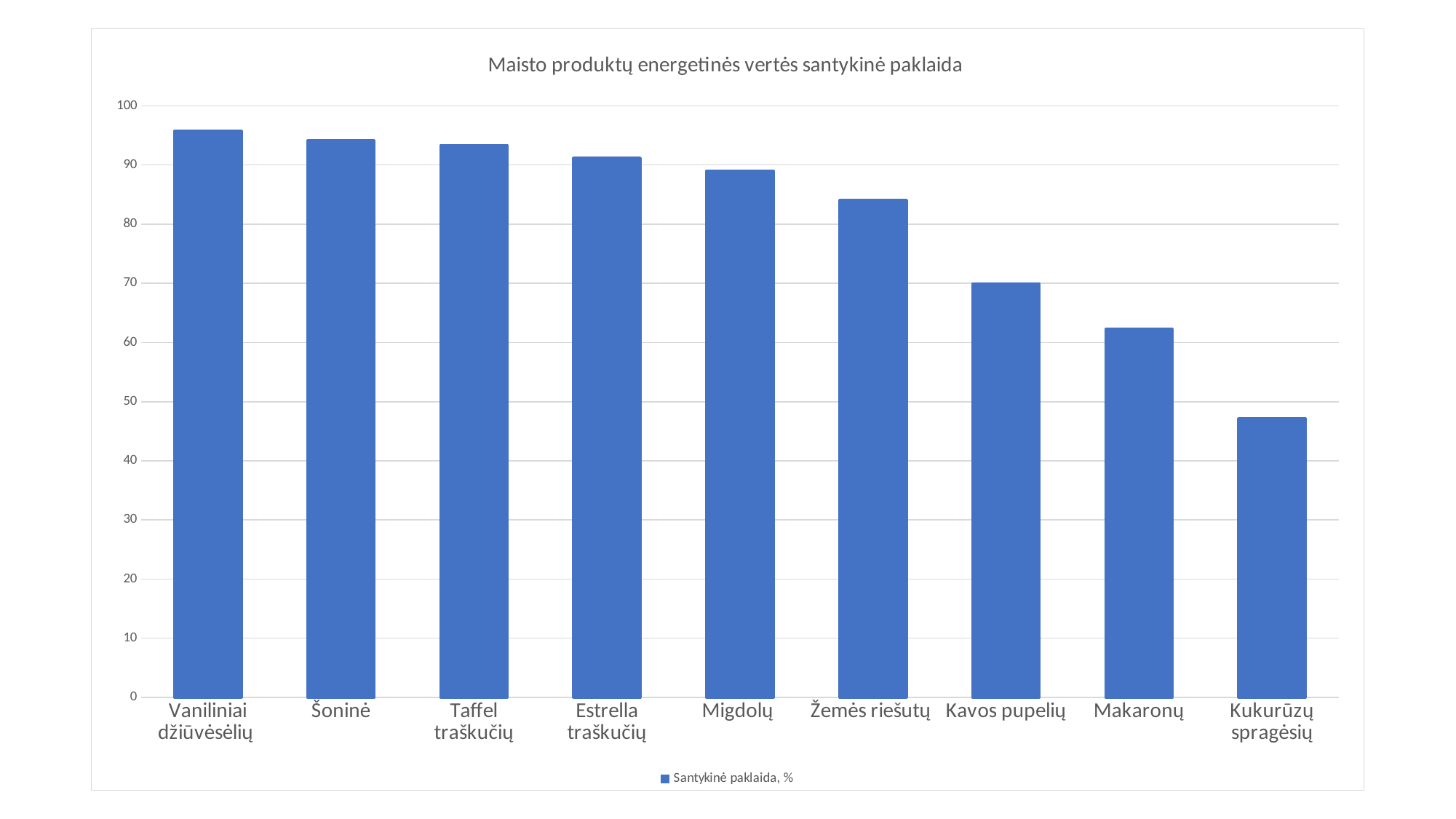
Which category has the highest value? Vaniliniai džiūvėsėlių How many food product categories are shown on the x axis? 9 What is the legend entry for the series? Santykinė paklaida, % Which category has the lowest value? Kukurūzų spragėsių Is the value for Žemės riešutų greater or less than 80? greater Which is larger, the value for Migdolų or the value for Makaronų? Migdolų How many series does the legend list? 1 What kind of chart is shown on the slide? bar chart Is the value for Makaronų greater or less than 60? greater Is the value for Kukurūzų spragėsių greater or less than 50? less What is the title of the chart? Maisto produktų energetinės vertės santykinė paklaida Do the values rise or fall from left to right along the x axis? fall